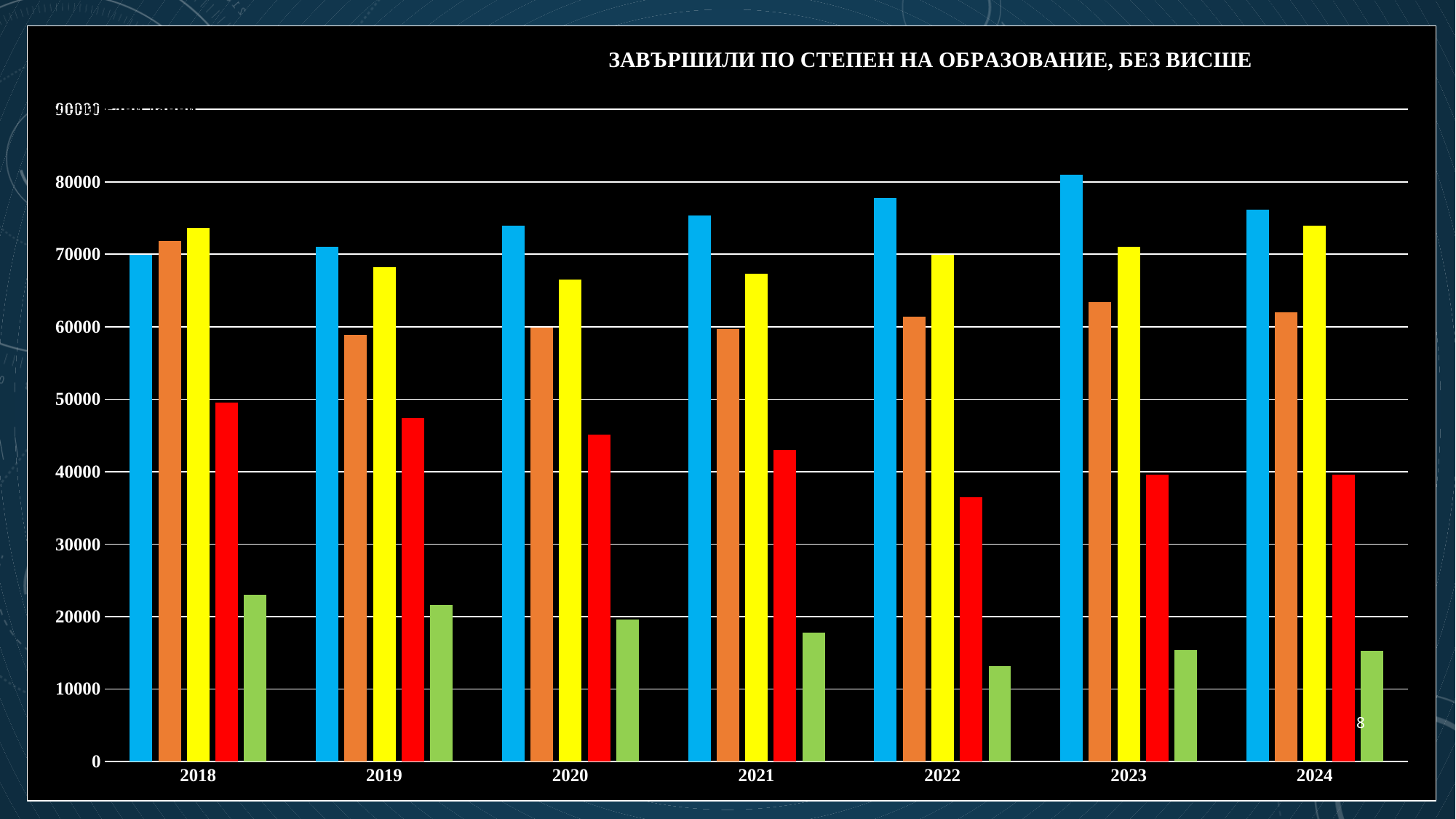
Is the value of the blue bar for 2023 greater or less than 80000? greater What kind of chart is shown on the slide? bar chart Is the value of the green bar for 2018 greater or less than 20000? greater In 2019, which is larger: the orange bar or the yellow bar? the yellow bar In which year is the blue bar the tallest? 2023 What is the title of the chart? ЗАВЪРШИЛИ ПО СТЕПЕН НА ОБРАЗОВАНИЕ, БЕЗ ВИСШЕ Do the red bars rise or fall from 2018 to 2022? fall How many years are shown on the x axis of the chart? 7 In which year is the green bar the shortest? 2022 In which year is the red bar the lowest? 2022 How many bars are there in each year group? 5 Is the value of the red bar for 2022 greater or less than 40000? less